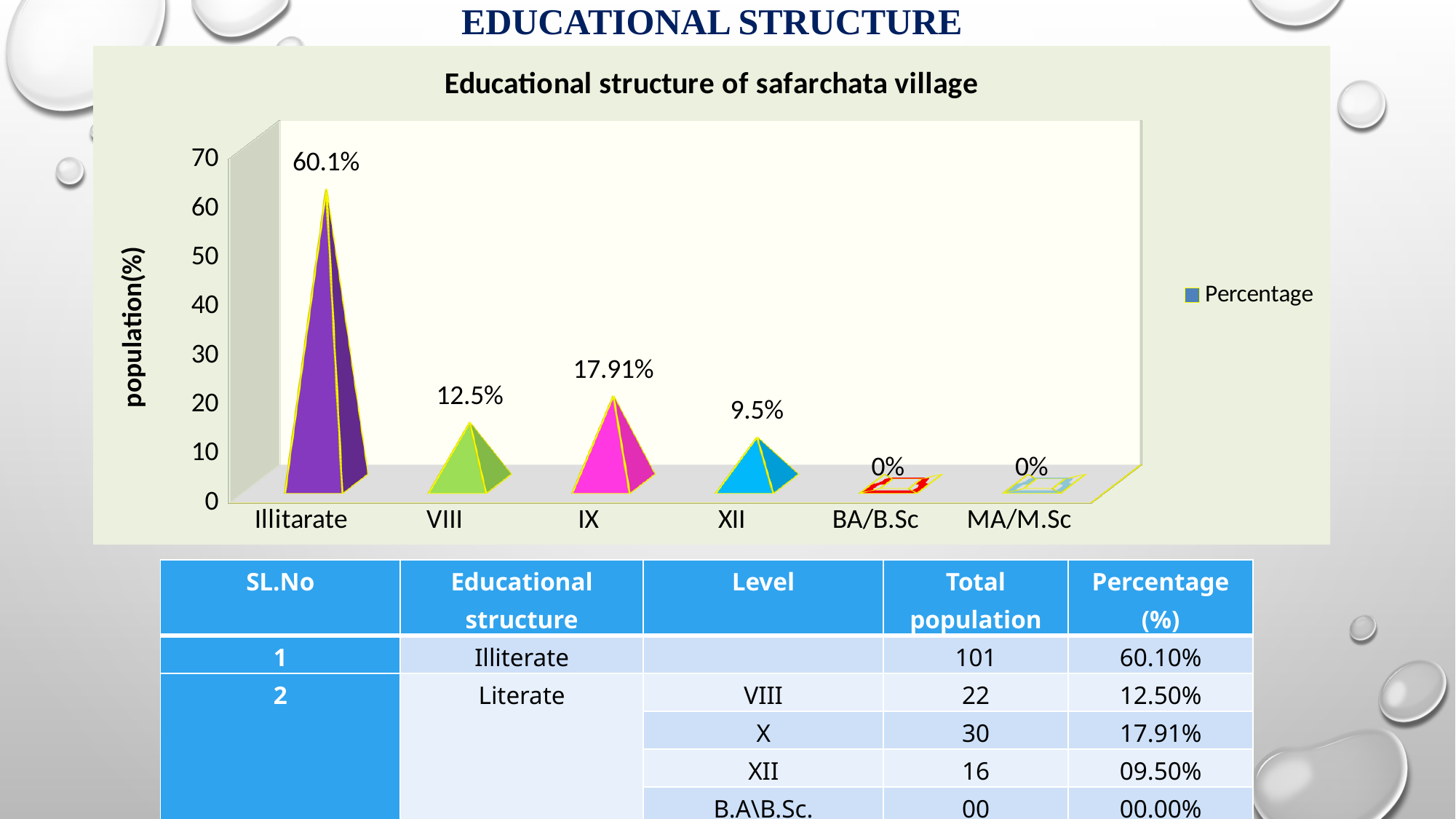
What is the difference between the values for IX and VIII? 5.41% What is the value for IX in the chart? 17.91% Is the value for Illitarate greater or less than 50? greater Which category has the highest value in the chart? Illitarate How many categories are shown on the x axis of the chart? 6 What is the title of the chart? Educational structure of safarchata village What is the value for VIII in the chart? 12.5% What is the label of the vertical axis of the chart? population(%) Which is larger, the value for IX or the value for XII? IX What is the value for Illitarate in the chart? 60.1% How many series does the chart legend list? 1 What is the value for XII in the chart? 9.5%